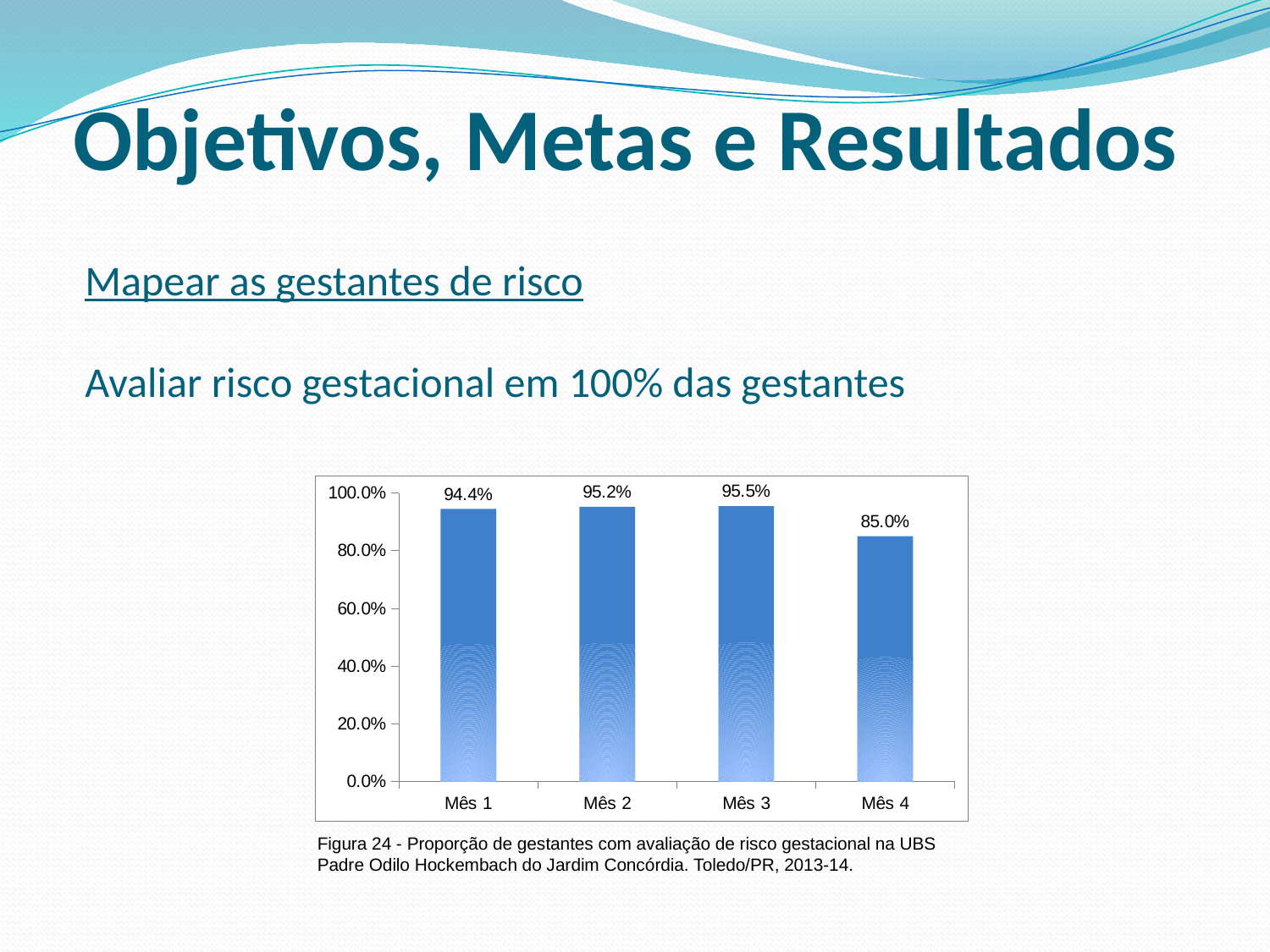
What is the value for Mês 3? 95.5% Which is larger, the value for Mês 1 or the value for Mês 4? Mês 1 How many months are shown on the x axis? 4 What is the difference between the values for Mês 3 and Mês 4? 10.5% What is the value for Mês 1? 94.4% What is the value for Mês 4? 85.0% Which month has the lowest value? Mês 4 What is the value for Mês 2? 95.2% What kind of chart is shown on the slide? bar chart Is the value for Mês 4 greater or less than 80.0%? greater What is the figure number given in the caption below the chart? Figura 24 What is the difference between the values for Mês 2 and Mês 1? 0.8%